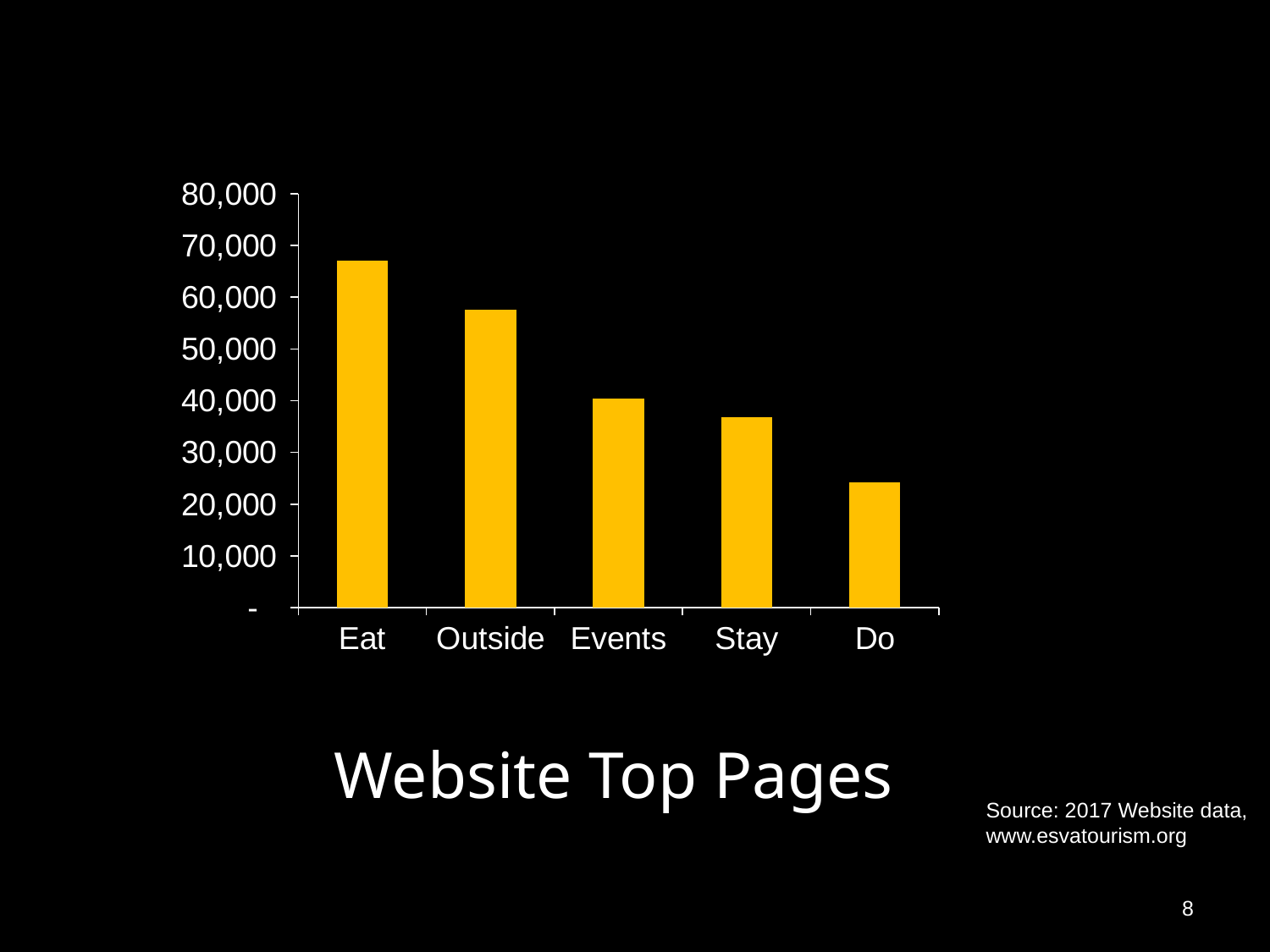
Do the values rise or fall moving from left to right along the x axis? fall Is the value for Do greater or less than 30,000? less Is the value for Outside greater or less than 50,000? greater What is the title of the chart? Website Top Pages How many categories are shown on the x axis? 5 Is the value for Eat greater or less than 60,000? greater Which page has the lowest value? Do Which page has the highest value? Eat Which is larger, the value for Eat or the value for Outside? Eat What kind of chart is shown on the slide? Bar chart Which is larger, the value for Events or the value for Stay? Events